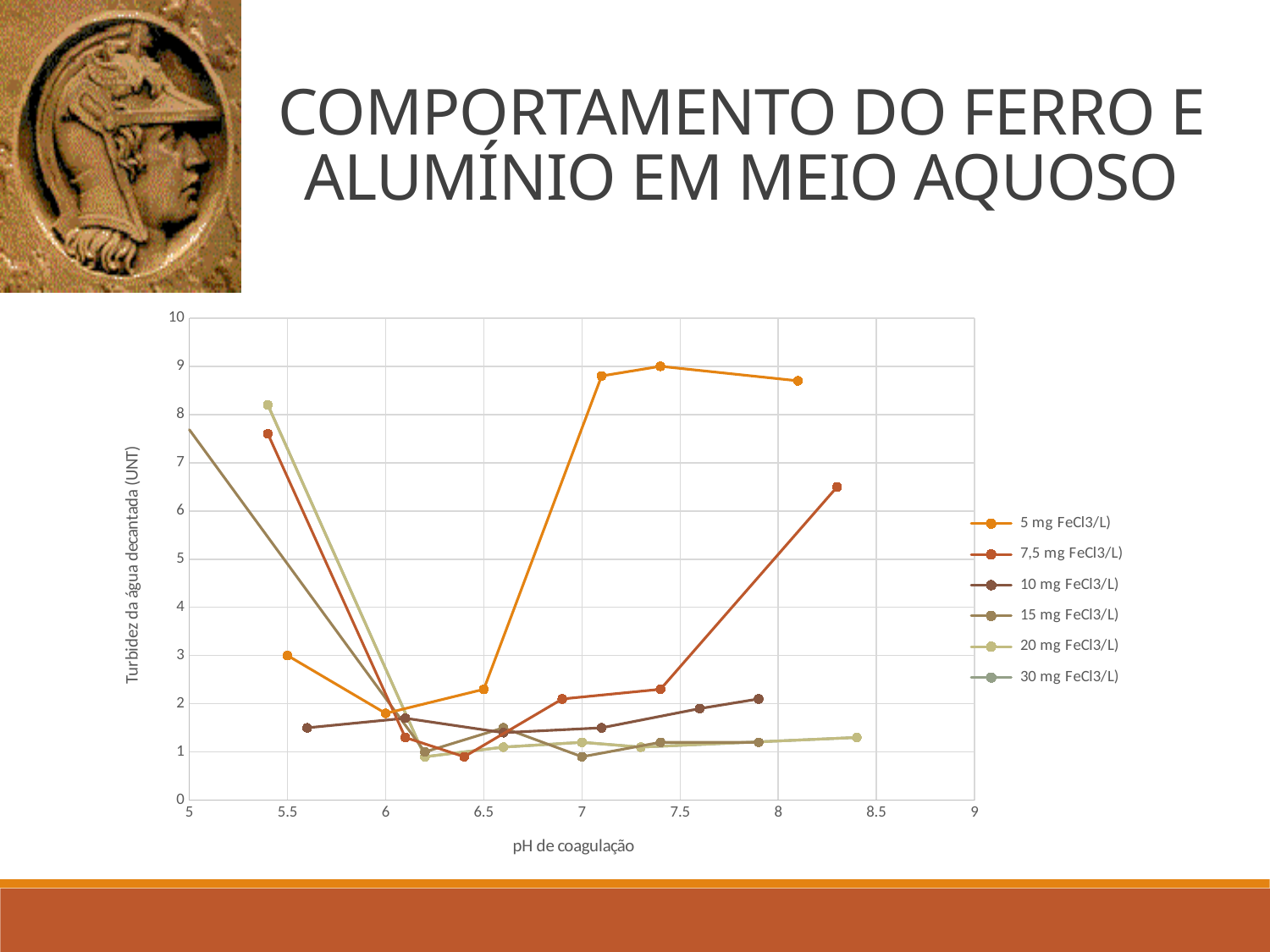
How many series does the legend list? 6 What is the label of the y axis? Turbidez da água decantada (UNT) Is the value for the 10 mg FeCl3/L series at its highest pH point (around 7.9) greater or less than 3? less What kind of chart is shown on the slide? line chart Is the value for the 7,5 mg FeCl3/L series at its highest pH point (around 8.3) greater or less than 6? greater Is the value for the 5 mg FeCl3/L series at pH 7.4 greater or less than 5? greater At pH around 7.4, which series has the larger turbidity: 5 mg FeCl3/L or 7,5 mg FeCl3/L? 5 mg FeCl3/L Does the 7,5 mg FeCl3/L series rise or fall between pH 5.4 and pH 6.1? fall Which series reaches the highest turbidity value on the chart? 5 mg FeCl3/L Does the 5 mg FeCl3/L series rise or fall between pH 6.5 and pH 7.1? rise What is the label of the x axis? pH de coagulação